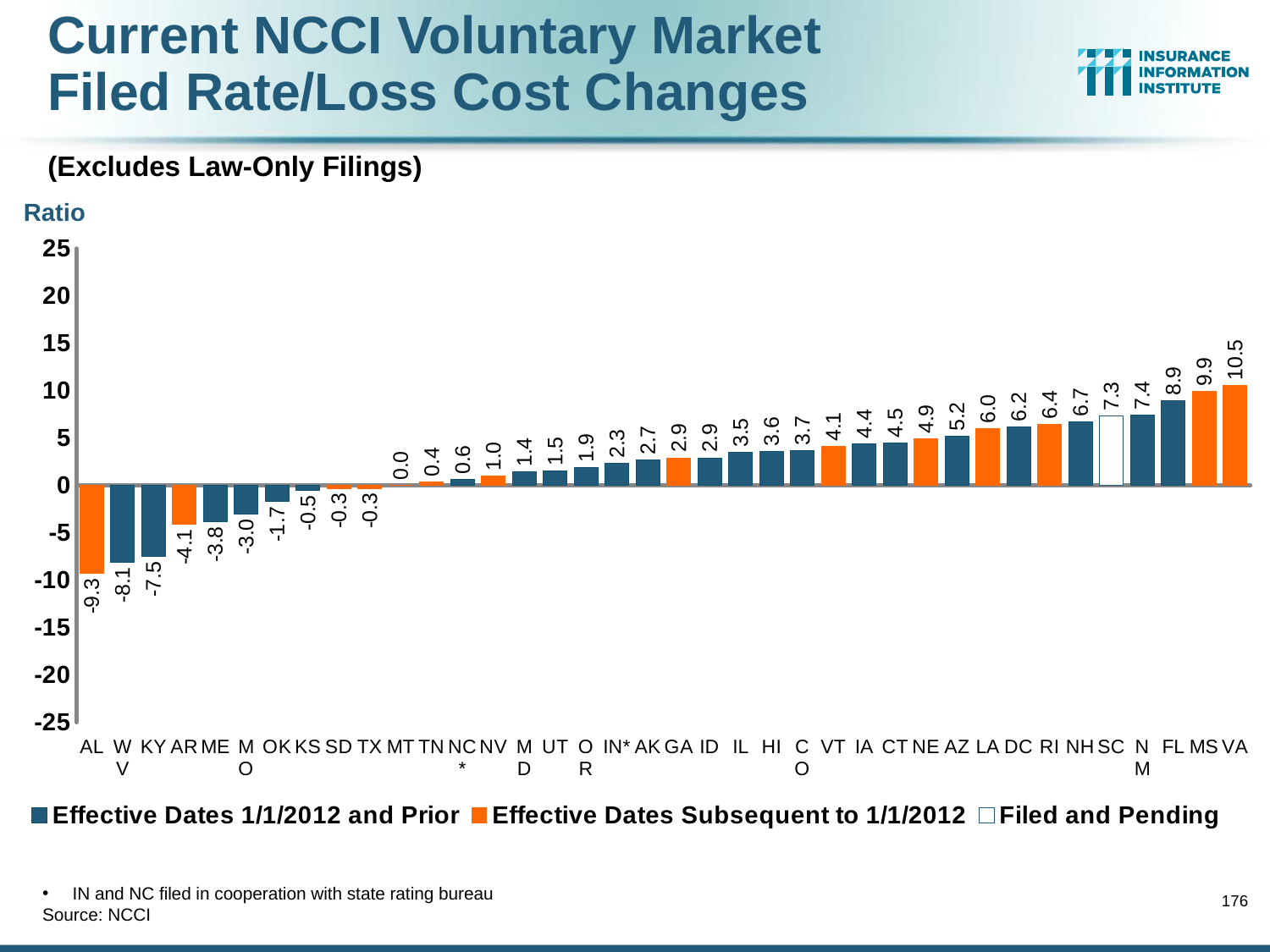
How many series does the legend list? 3 Do the values rise or fall from left to right along the x axis? Rise How many states are shown on the x axis? 38 What is the value for MT? 0.0 What is the difference between the values for VA and AL? 19.8 Which is larger, the value for FL or the value for MS? MS Which state has the highest value? VA Which state has the lowest value? AL What is the value for AL? -9.3 What kind of chart is this? Bar chart Which state's bar is shown as Filed and Pending? SC What is the value for VA? 10.5